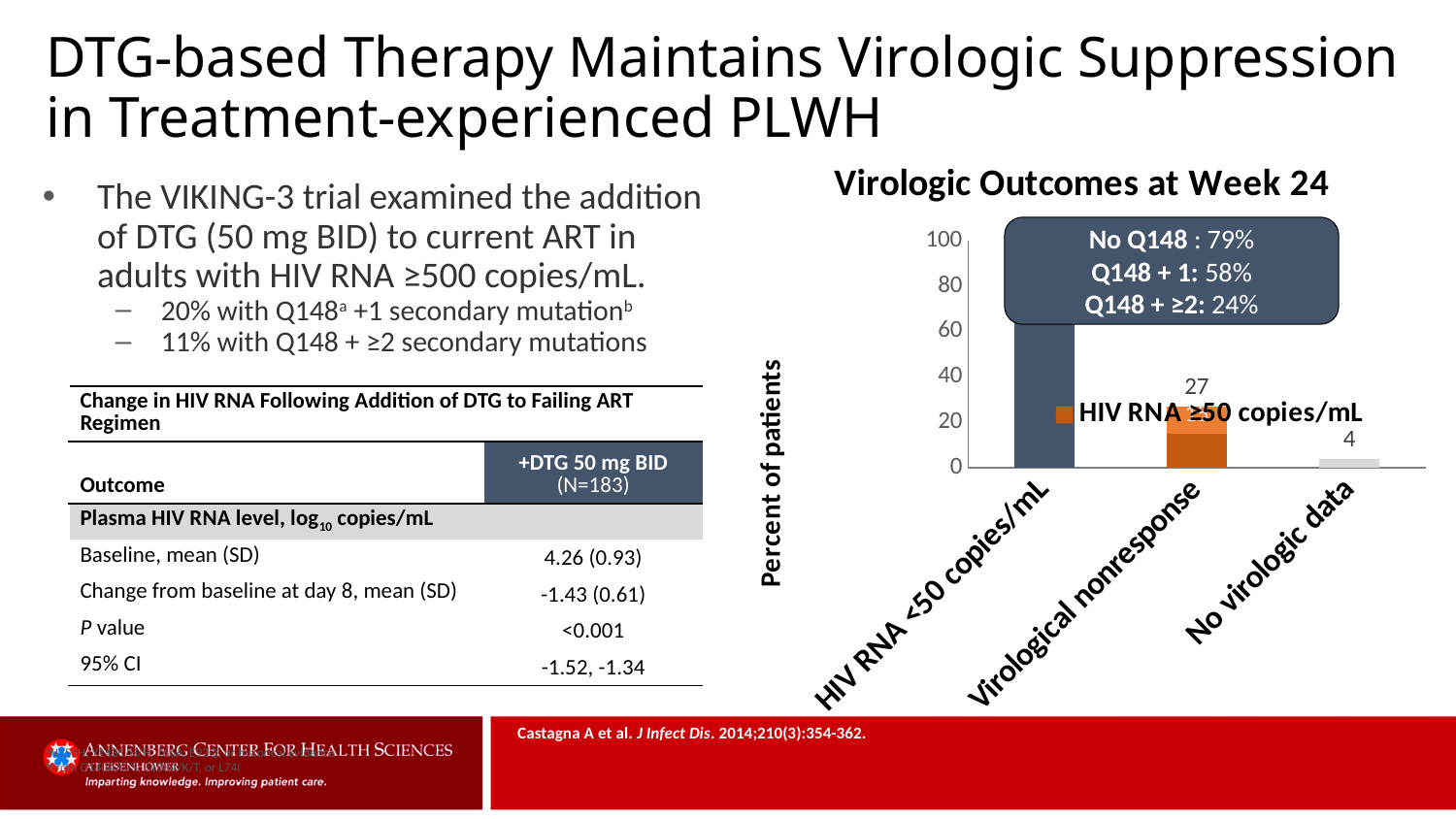
In the Virologic Outcomes at Week 24 chart, is the value for Virological nonresponse greater or less than 40? less In the Virologic Outcomes at Week 24 chart, which category has the highest value? HIV RNA <50 copies/mL What is the label on the vertical axis of the Virologic Outcomes at Week 24 chart? Percent of patients In the Virologic Outcomes at Week 24 chart, what is the value for No virologic data? 4 How many categories are shown in the Virologic Outcomes at Week 24 chart? 3 In the Virologic Outcomes at Week 24 chart, which is larger: Virological nonresponse or No virologic data? Virological nonresponse In the Virologic Outcomes at Week 24 chart, is the value for HIV RNA <50 copies/mL greater or less than 60? greater In the Virologic Outcomes at Week 24 chart, what is the difference between the values for Virological nonresponse and No virologic data? 23 In the Virologic Outcomes at Week 24 chart, which category has the lowest value? No virologic data What is the title of the chart on the slide? Virologic Outcomes at Week 24 In the Virologic Outcomes at Week 24 chart, what is the value for Virological nonresponse? 27 What kind of chart is the Virologic Outcomes at Week 24 chart? bar chart